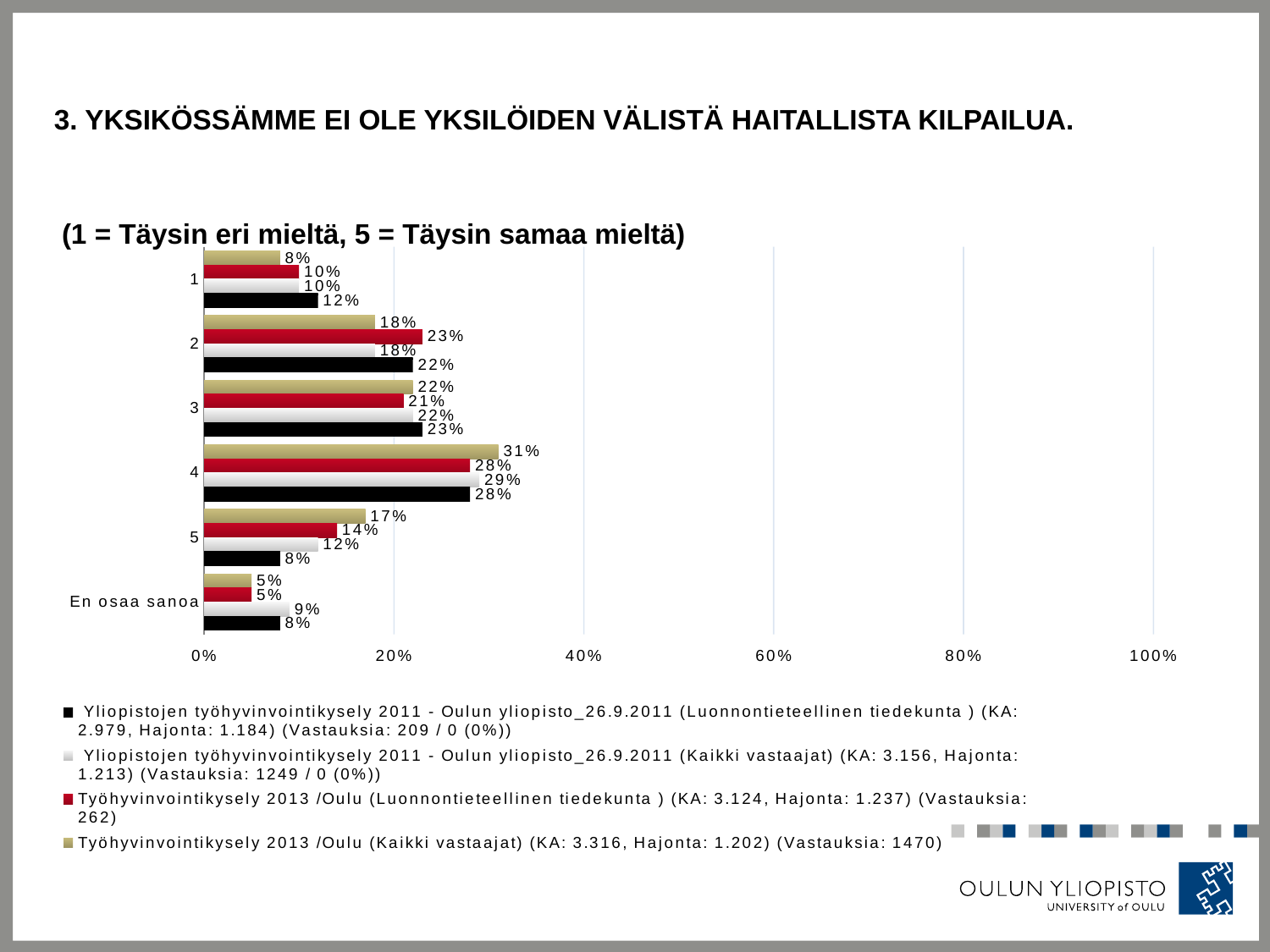
Which category has the highest value in the Työhyvinvointikysely 2013 /Oulu (Kaikki vastaajat) series? 4 What is the value for En osaa sanoa in the Yliopistojen työhyvinvointikysely 2011 (Kaikki vastaajat) series? 9% What is the difference between the Työhyvinvointikysely 2013 /Oulu (Kaikki vastaajat) value and the Yliopistojen työhyvinvointikysely 2011 (Luonnontieteellinen tiedekunta) value for category 5? 9% What is the value for category 4 in the Työhyvinvointikysely 2013 /Oulu (Kaikki vastaajat) series? 31% What type of chart is shown on the slide? bar chart How many series does the legend list? 4 What is the value for category 2 in the Työhyvinvointikysely 2013 /Oulu (Luonnontieteellinen tiedekunta) series? 23% Which category has the lowest value in the Yliopistojen työhyvinvointikysely 2011 (Kaikki vastaajat) series? En osaa sanoa Is the value for category 4 in the Työhyvinvointikysely 2013 /Oulu (Kaikki vastaajat) series greater or less than 20%? greater What is the value for category 5 in the Yliopistojen työhyvinvointikysely 2011 (Luonnontieteellinen tiedekunta) series? 8% For category 1, which is larger: the Yliopistojen työhyvinvointikysely 2011 (Luonnontieteellinen tiedekunta) value or the Työhyvinvointikysely 2013 /Oulu (Kaikki vastaajat) value? Yliopistojen työhyvinvointikysely 2011 (Luonnontieteellinen tiedekunta) How many categories are shown on the vertical axis? 6